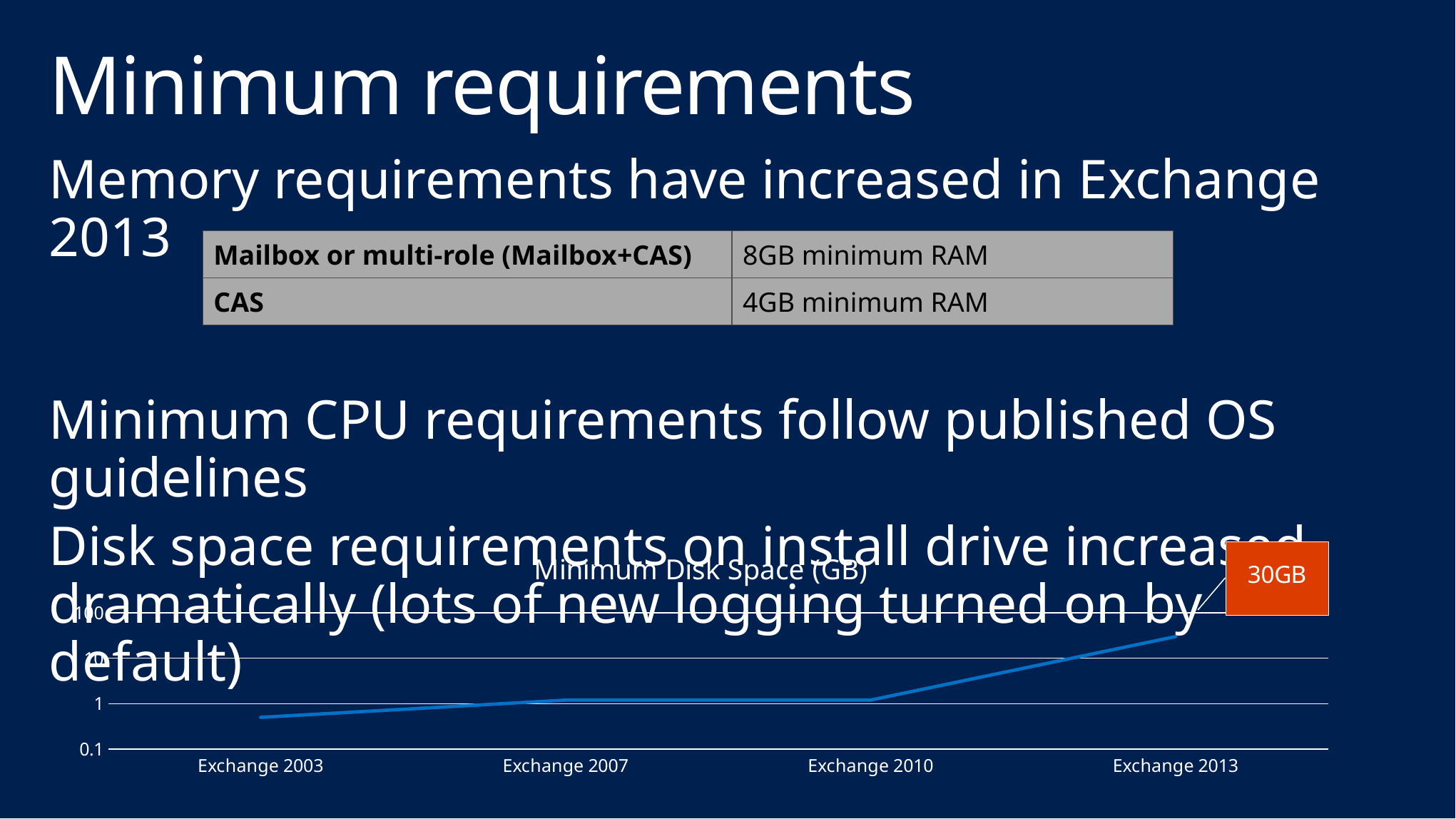
Do the minimum disk space values rise or fall from Exchange 2003 to Exchange 2013? rise What is the lowest tick value shown on the chart's y axis? 0.1 What kind of chart is shown on the slide? line chart What minimum disk space value is called out for Exchange 2013 in the chart? 30GB How many Exchange versions are plotted on the x axis of the chart? 4 Which Exchange version has the highest minimum disk space in the chart? Exchange 2013 Is the minimum disk space for Exchange 2003 greater or less than 1? less Which Exchange version has the lowest minimum disk space in the chart? Exchange 2003 Which has the larger minimum disk space, Exchange 2003 or Exchange 2013? Exchange 2013 What is the title of the chart? Minimum Disk Space (GB) Is the minimum disk space for Exchange 2013 greater or less than 10? greater Is the minimum disk space for Exchange 2010 greater or less than 10? less